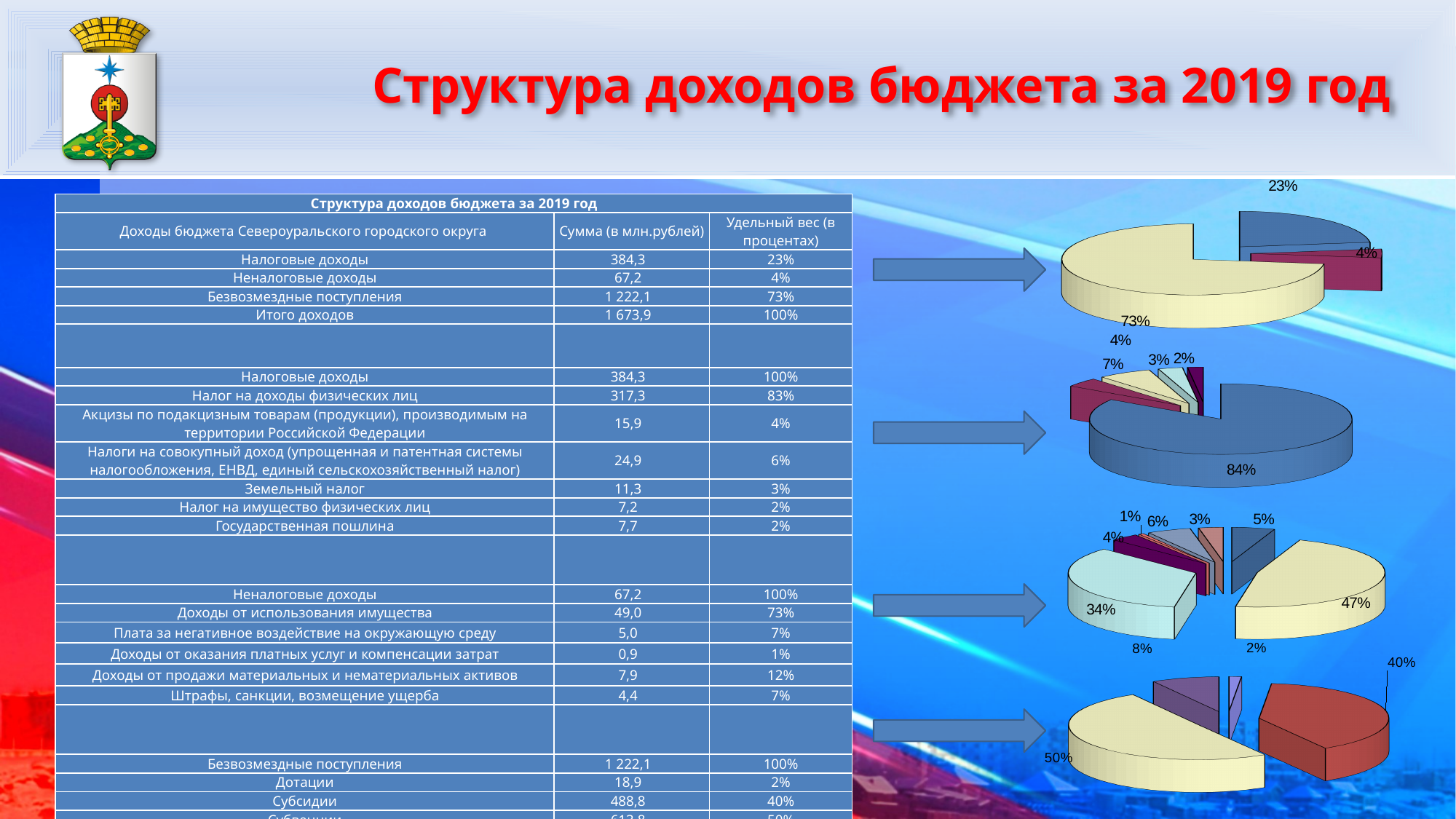
In the bottom pie chart, what is the label of the largest slice? 50% What is the title of the table on the left of the slide? Структура доходов бюджета за 2019 год How many pie charts are shown on the slide? 4 In the top pie chart, what is the difference in percentage points between the largest slice (73%) and the 23% slice? 50 percentage points What kind of chart is the top chart on the right side of the slide? pie chart In the third pie chart from the top, what is the label of the largest slice? 47% In the second pie chart from the top, what is the label of the largest slice? 84% In the top pie chart, what is the label of the smallest slice? 4% How many slices does the second pie chart from the top have? 5 How many slices does the top pie chart have? 3 In the third pie chart from the top, which slice is larger: the one labelled 34% or the one labelled 47%? 47%